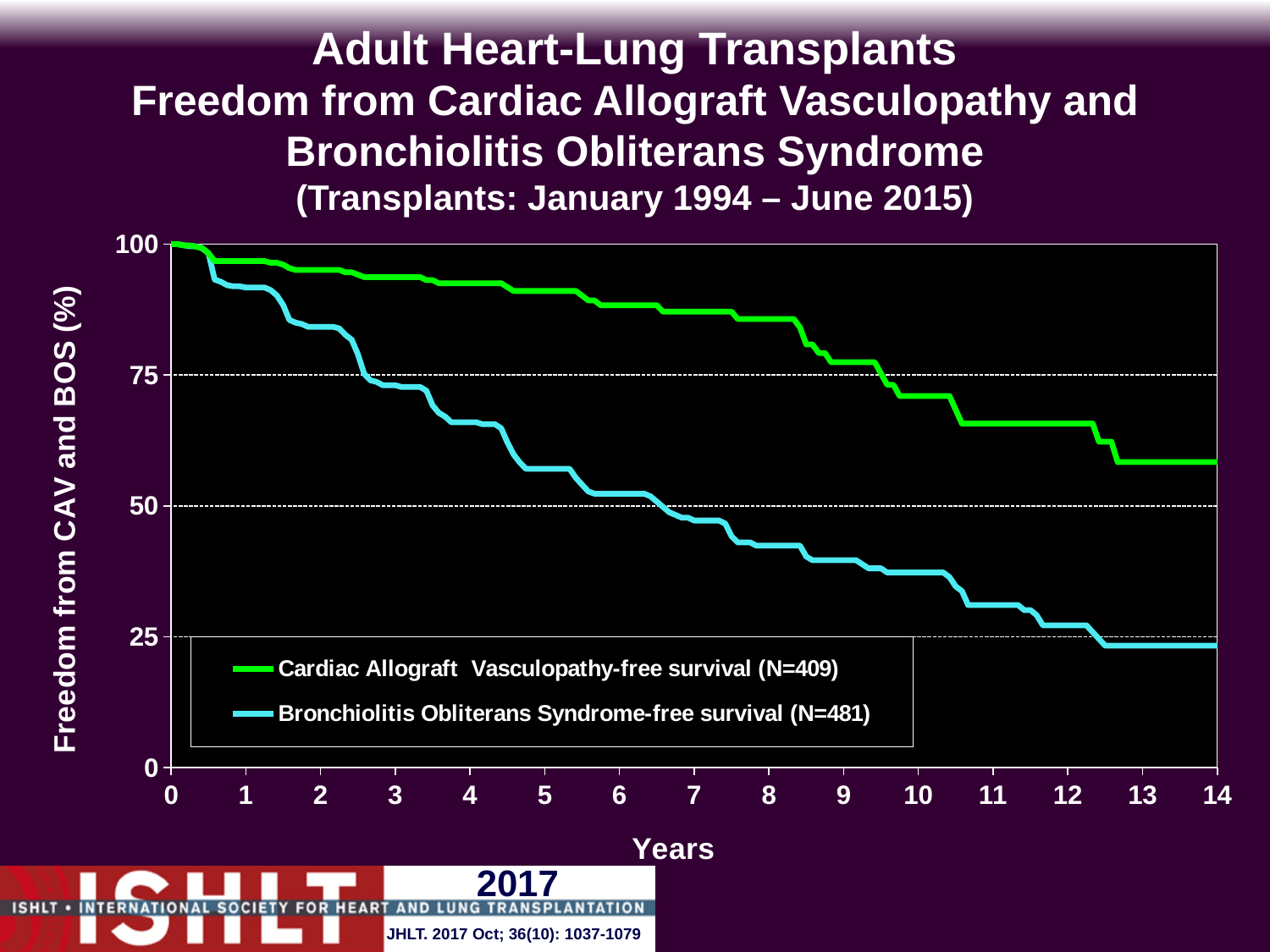
Is the Cardiac Allograft Vasculopathy-free survival value at 5 years greater or less than 75? greater Is the Cardiac Allograft Vasculopathy-free survival value at 14 years greater or less than 50? greater What is the N for the Bronchiolitis Obliterans Syndrome-free survival series in the legend? N=481 Is the Bronchiolitis Obliterans Syndrome-free survival value at 5 years greater or less than 50? greater Do the values of the Bronchiolitis Obliterans Syndrome-free survival series rise or fall as years increase? Fall How many series does the legend list? 2 What is the N for the Cardiac Allograft Vasculopathy-free survival series in the legend? N=409 What kind of chart is shown on the slide? Line chart At 10 years, which series has the higher value: Cardiac Allograft Vasculopathy-free survival or Bronchiolitis Obliterans Syndrome-free survival? Cardiac Allograft Vasculopathy-free survival